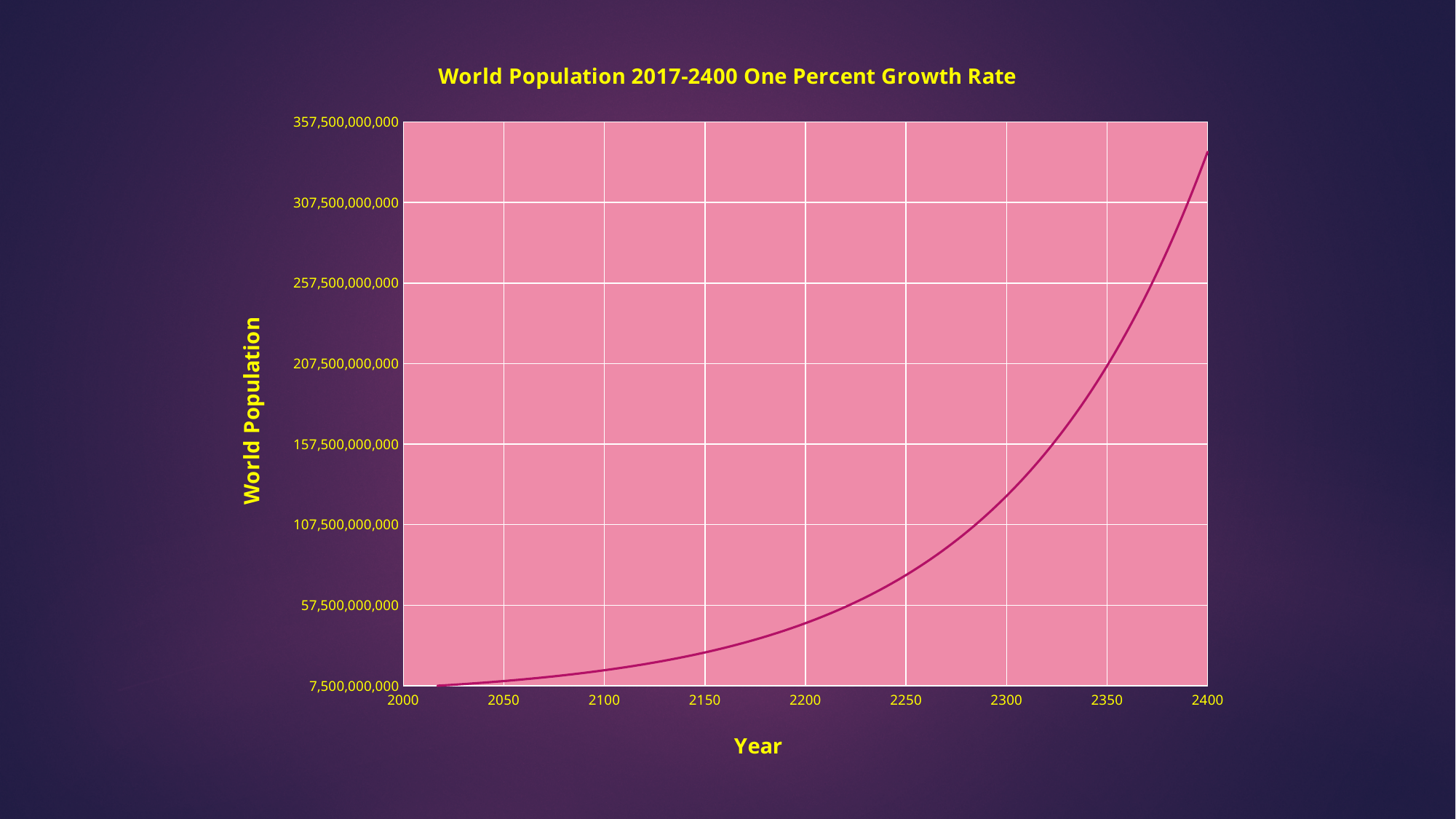
Is the world population value at the year 2200 greater or less than 57,500,000,000? less What is the title of the chart? World Population 2017-2400 One Percent Growth Rate Is the world population value at the year 2300 greater or less than 107,500,000,000? greater Is the world population value at the year 2400 greater or less than 307,500,000,000? greater What kind of chart is shown on the slide? line chart Does the world population line rise or fall as the year increases along the x axis? rise Which year has the larger world population value on the chart, 2200 or 2300? 2300 At which year shown on the x axis does the world population line reach its highest value? 2400 What is the label on the vertical axis of the chart? World Population